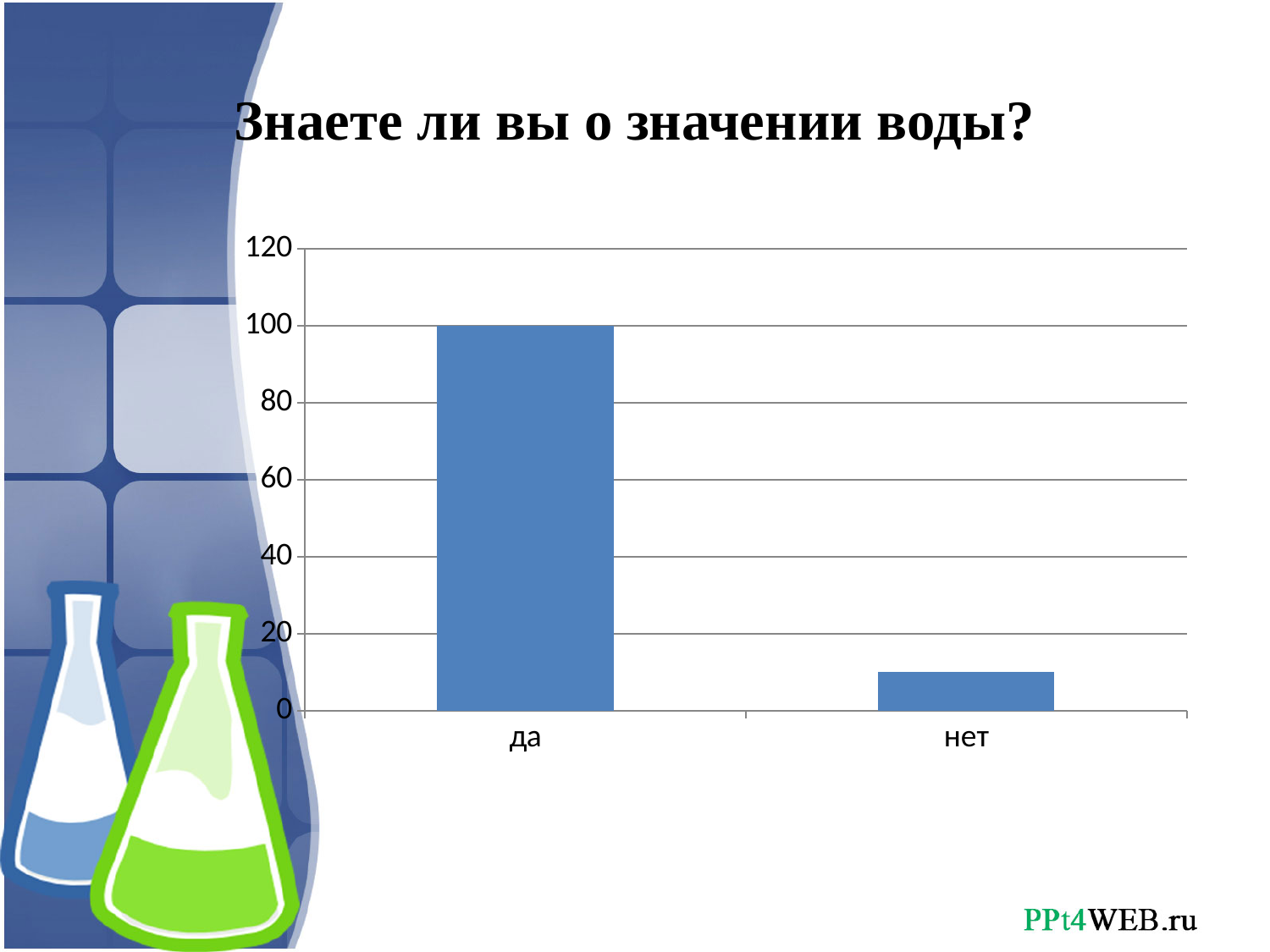
Which category has the lowest value? нет Which category has the highest value? да Which is larger, the value for "да" or the value for "нет"? да What is the value for "да"? 100 How many categories are shown on the x axis? 2 What kind of chart is shown on the slide? bar chart What is the title of the slide above the chart? Знаете ли вы о значении воды? Is the value for "нет" greater or less than 20? less What is the highest value shown on the vertical axis? 120 Is the value for "да" greater or less than 80? greater